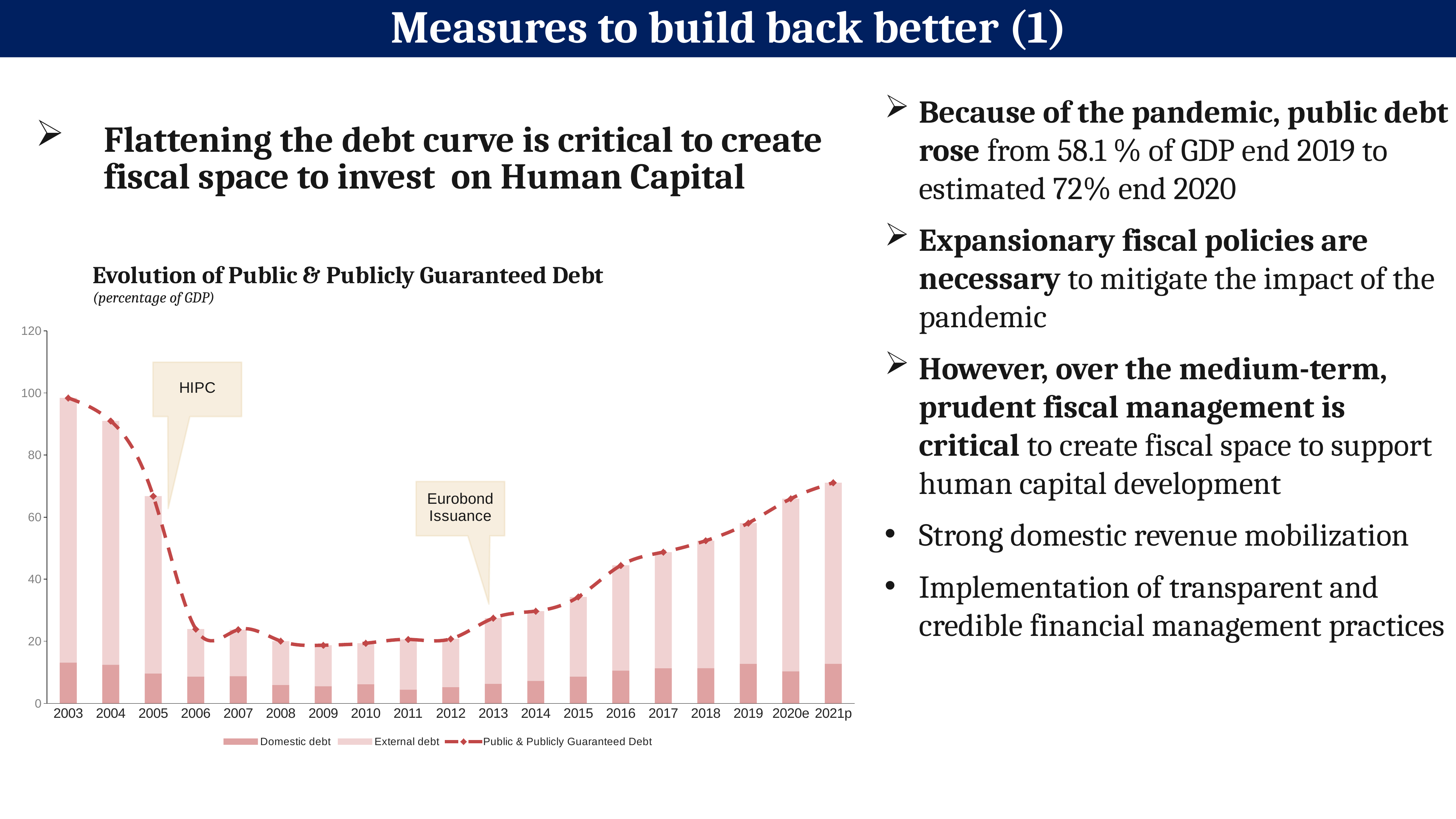
What kind of chart is shown on the slide? A stacked bar chart with a line Which year has the higher Public & Publicly Guaranteed Debt, 2013 or 2018? 2018 Which year has the higher Public & Publicly Guaranteed Debt, 2005 or 2006? 2005 How many years (categories) are shown on the x axis of the chart? 19 Is the Public & Publicly Guaranteed Debt value for 2009 greater or less than 40? less Is the Public & Publicly Guaranteed Debt value for 2021p greater or less than 60? greater Is the Public & Publicly Guaranteed Debt value for 2003 greater or less than 80? greater Does the Public & Publicly Guaranteed Debt line rise or fall from 2013 to 2021p? Rise What unit is the chart's data expressed in, according to the subtitle? Percentage of GDP In which year is the Public & Publicly Guaranteed Debt line at its highest? 2003 How many series does the chart legend list? 3